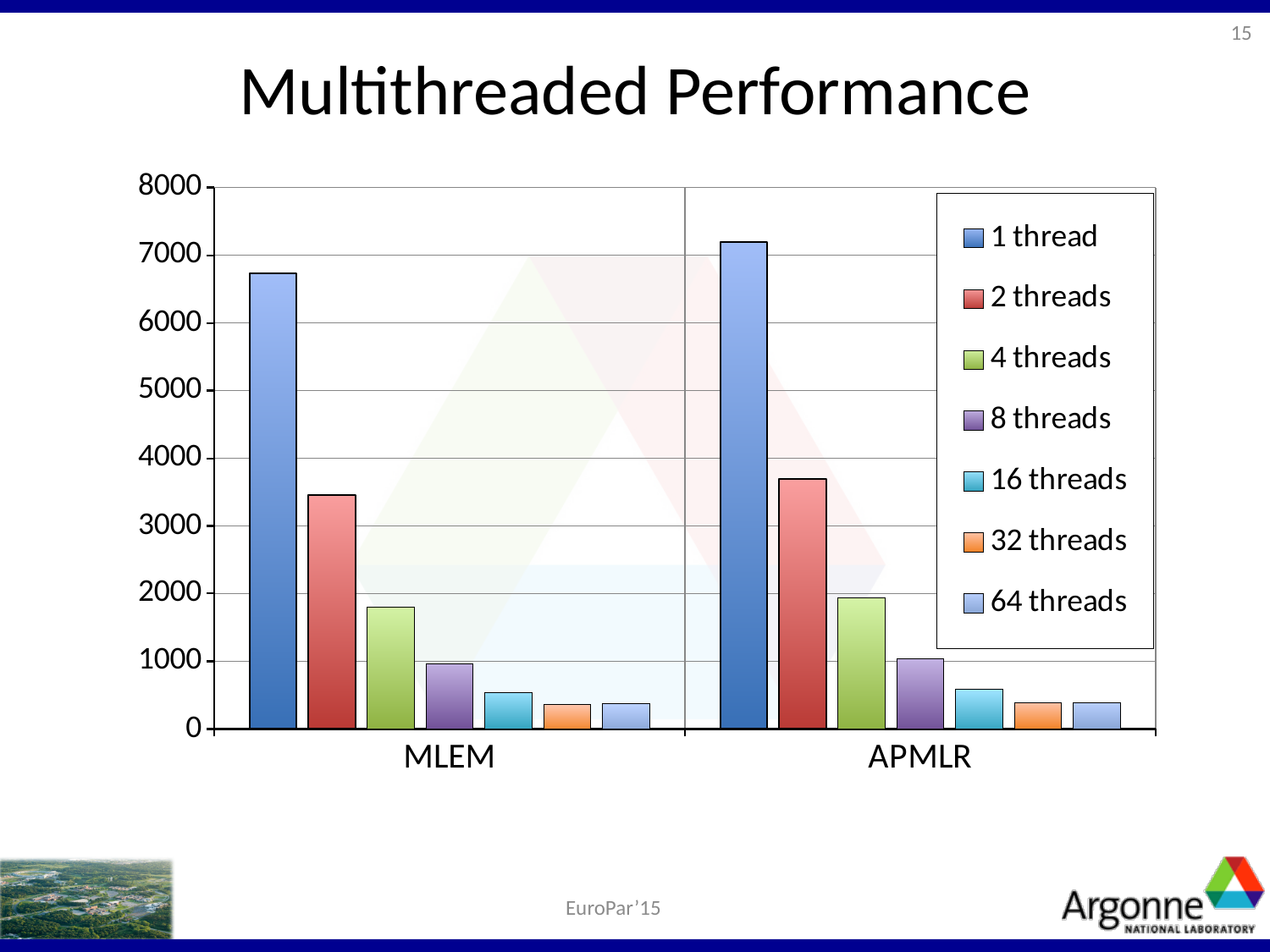
Is the 1 thread value for APMLR greater or less than 7000? greater How many categories are shown on the x axis? 2 Is the 16 threads value for APMLR greater or less than 1000? less Is the 1 thread value for MLEM greater or less than 7000? less Which is larger, the 1 thread value for MLEM or the 1 thread value for APMLR? APMLR How many series does the legend list? 7 Which series has the highest value for MLEM? 1 thread Which series has the highest value for APMLR? 1 thread What is the title of the chart? Multithreaded Performance What kind of chart is shown on the slide? bar chart